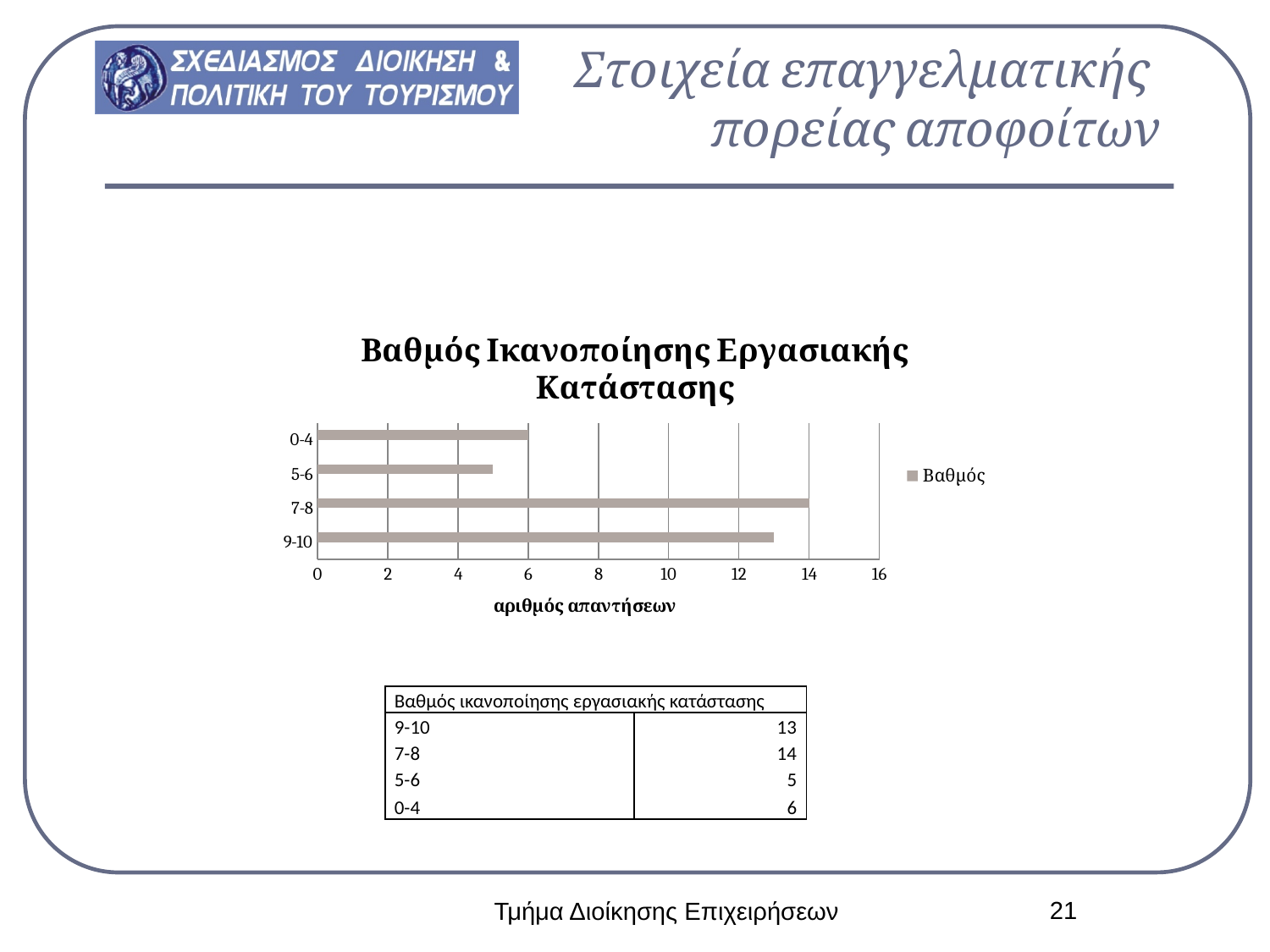
How many series does the legend list? 1 Which category has the lowest value? 5-6 What kind of chart is shown on the slide? bar chart What is the title of the chart? Βαθμός Ικανοποίησης Εργασιακής Κατάστασης How many categories does the chart show? 4 What is the value for the 5-6 category? 5 What is the value for the 7-8 category? 14 What is the value for the 0-4 category? 6 Which category has the highest value? 7-8 What is the difference between the values for 7-8 and 5-6? 9 Is the value for 9-10 greater or less than 12? greater What is the value for the 9-10 category? 13